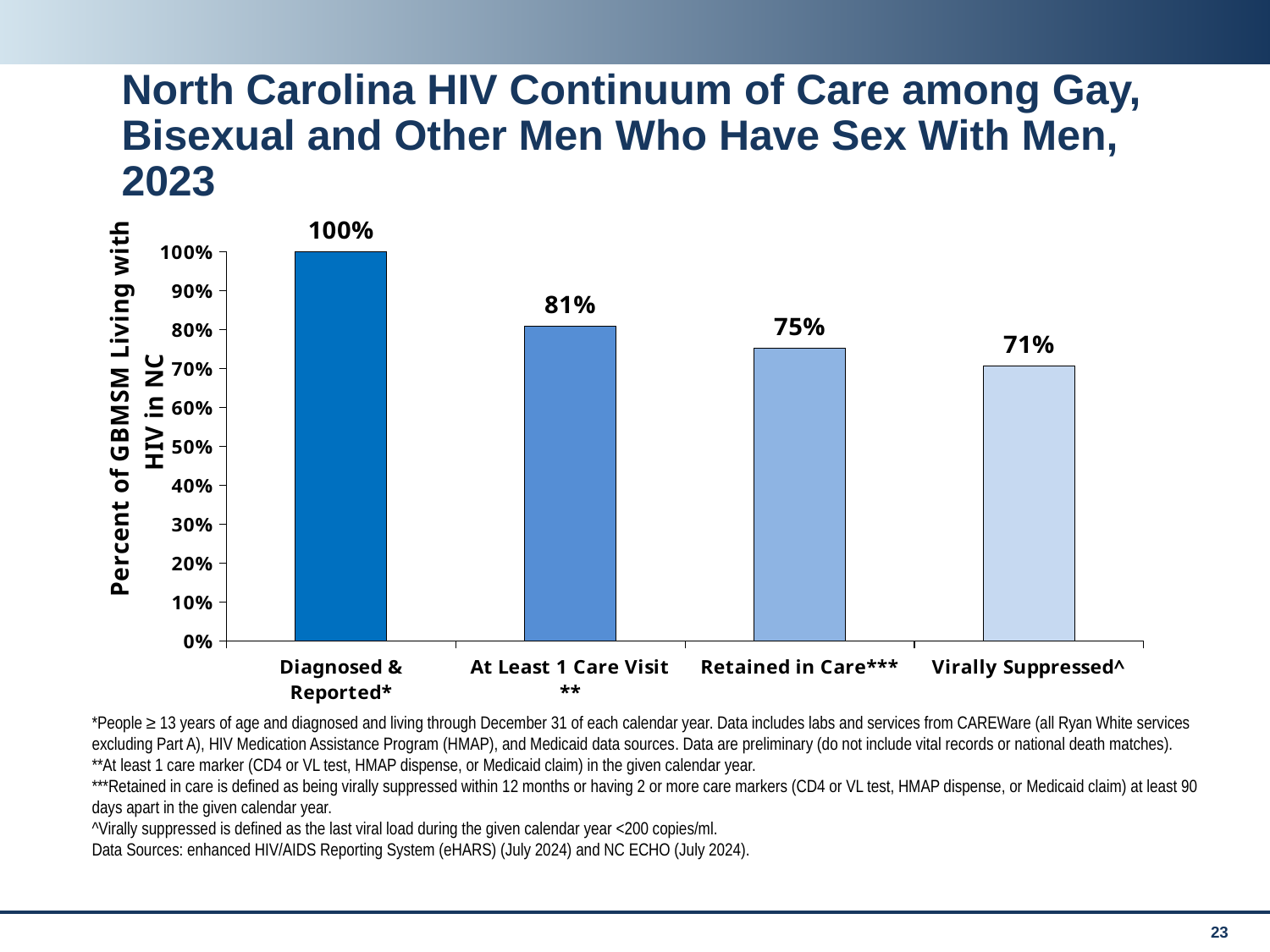
What kind of chart is shown on the slide? Bar chart Which category has the highest value? Diagnosed & Reported What is the value for At Least 1 Care Visit? 81% How many categories are shown on the x axis? 4 Which category has the lowest value? Virally Suppressed What is the difference between the values for At Least 1 Care Visit and Virally Suppressed? 10% What is the value for Virally Suppressed? 71% What is the value for Retained in Care? 75% What is the difference between the values for Diagnosed & Reported and Retained in Care? 25% Which is larger, the value for Retained in Care or the value for Virally Suppressed? Retained in Care What is the value for Diagnosed & Reported? 100% Do the values rise or fall from left to right along the x axis? Fall